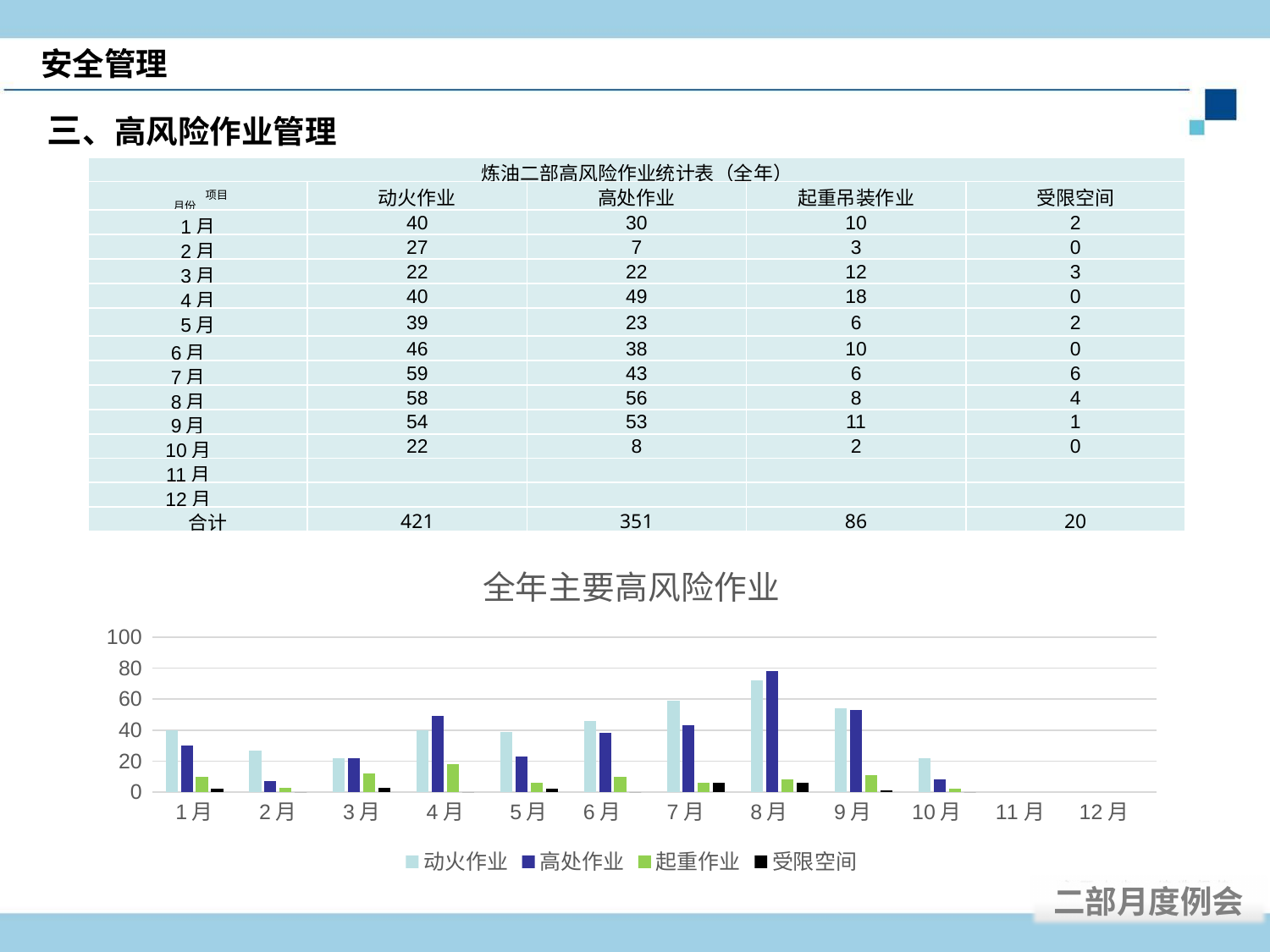
Which series are listed in the chart legend? 动火作业, 高处作业, 起重作业, 受限空间 How many series does the chart legend list? 4 What is the title of the chart? 全年主要高风险作业 Is the 动火作业 value for 10月 greater or less than 40? less Is the 动火作业 value for 2月 greater or less than 40? less What kind of chart is shown on the slide? bar chart In 4月, which is larger, 高处作业 or 动火作业? 高处作业 How many month categories are shown on the x axis of the chart? 12 Is the 动火作业 value for 7月 greater or less than 40? greater In which month is the 高处作业 bar the tallest? 8月 In 1月, which is larger, 动火作业 or 高处作业? 动火作业